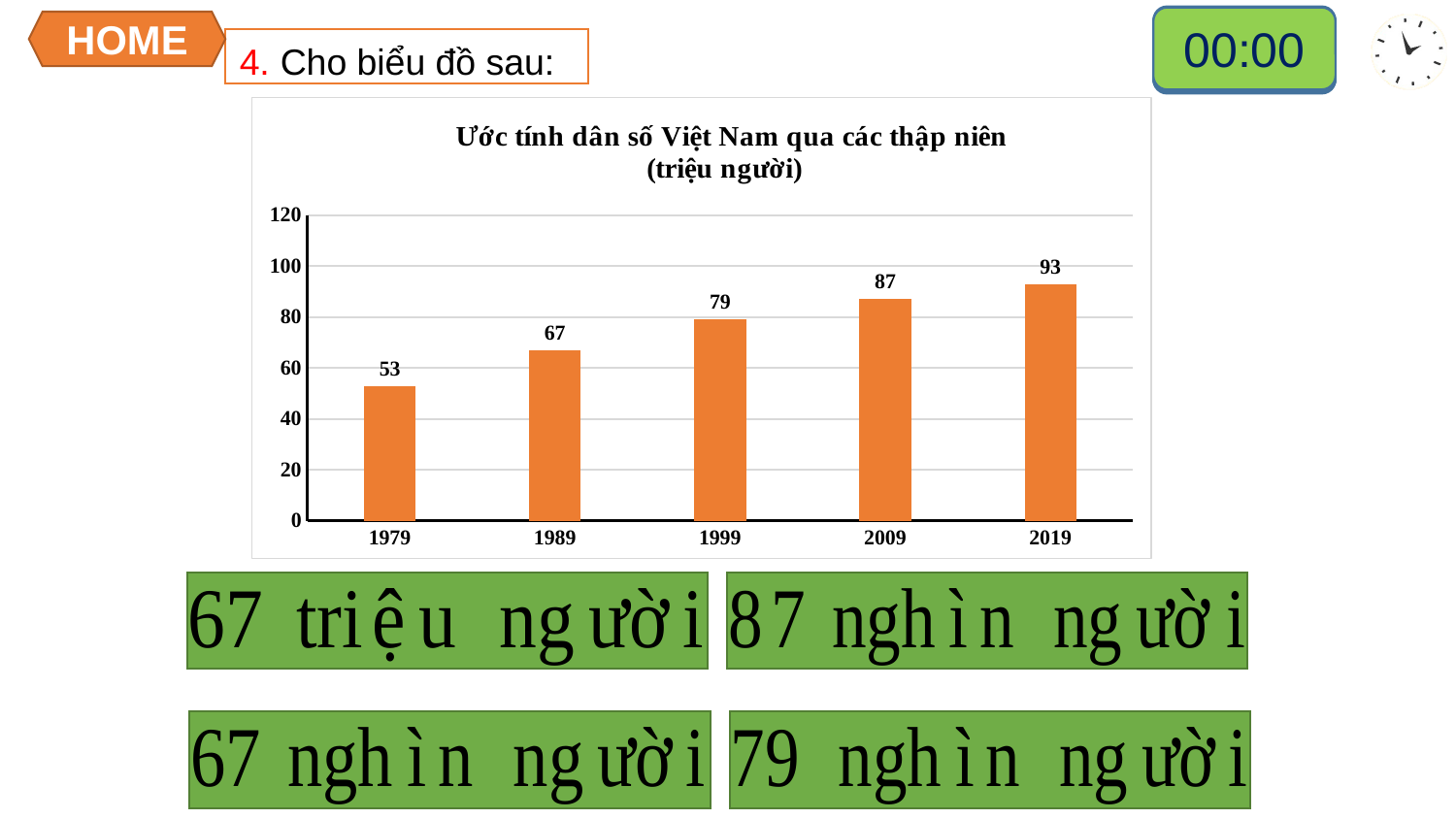
What is the value for 1979? 53 What is the value for 2009? 87 Which is larger, the value for 1999 or the value for 2009? 2009 What kind of chart is this? bar chart How many years are shown on the x axis? 5 Is the value for 2019 greater or less than 100? less What is the value for 1989? 67 What is the difference between the values for 1999 and 1989? 12 What is the difference between the values for 2019 and 1979? 40 Which year has the highest value? 2019 Do the values rise or fall from 1979 to 2019? rise Which year has the lowest value? 1979